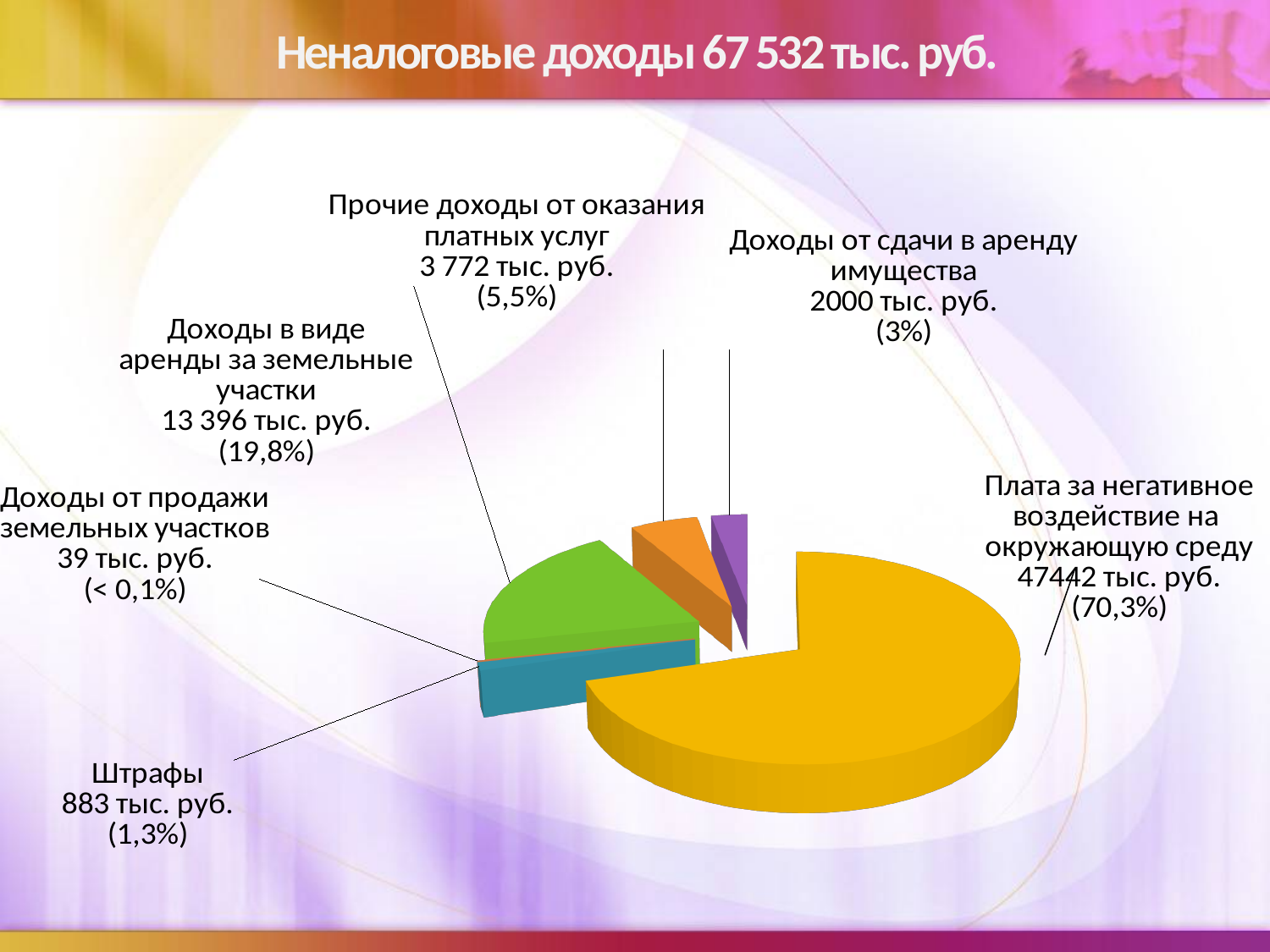
Which category has the smallest slice of the pie? Доходы от продажи земельных участков What is the value for Плата за негативное воздействие на окружающую среду? 47442 тыс. руб. What share of the pie does Доходы от сдачи в аренду имущества represent? 3% What is the value for Штрафы? 883 тыс. руб. What is the value for Доходы в виде аренды за земельные участки? 13 396 тыс. руб. How many slices does the pie chart have? 6 What is the title of the chart on the slide? Неналоговые доходы 67 532 тыс. руб. What share of the pie does Прочие доходы от оказания платных услуг represent? 5,5% What kind of chart is shown on the slide? Pie chart Which category has the largest slice of the pie? Плата за негативное воздействие на окружающую среду Which is larger: the value for Доходы от сдачи в аренду имущества or the value for Штрафы? Доходы от сдачи в аренду имущества What is the difference between the values for Прочие доходы от оказания платных услуг and Доходы от сдачи в аренду имущества? 1 772 тыс. руб.